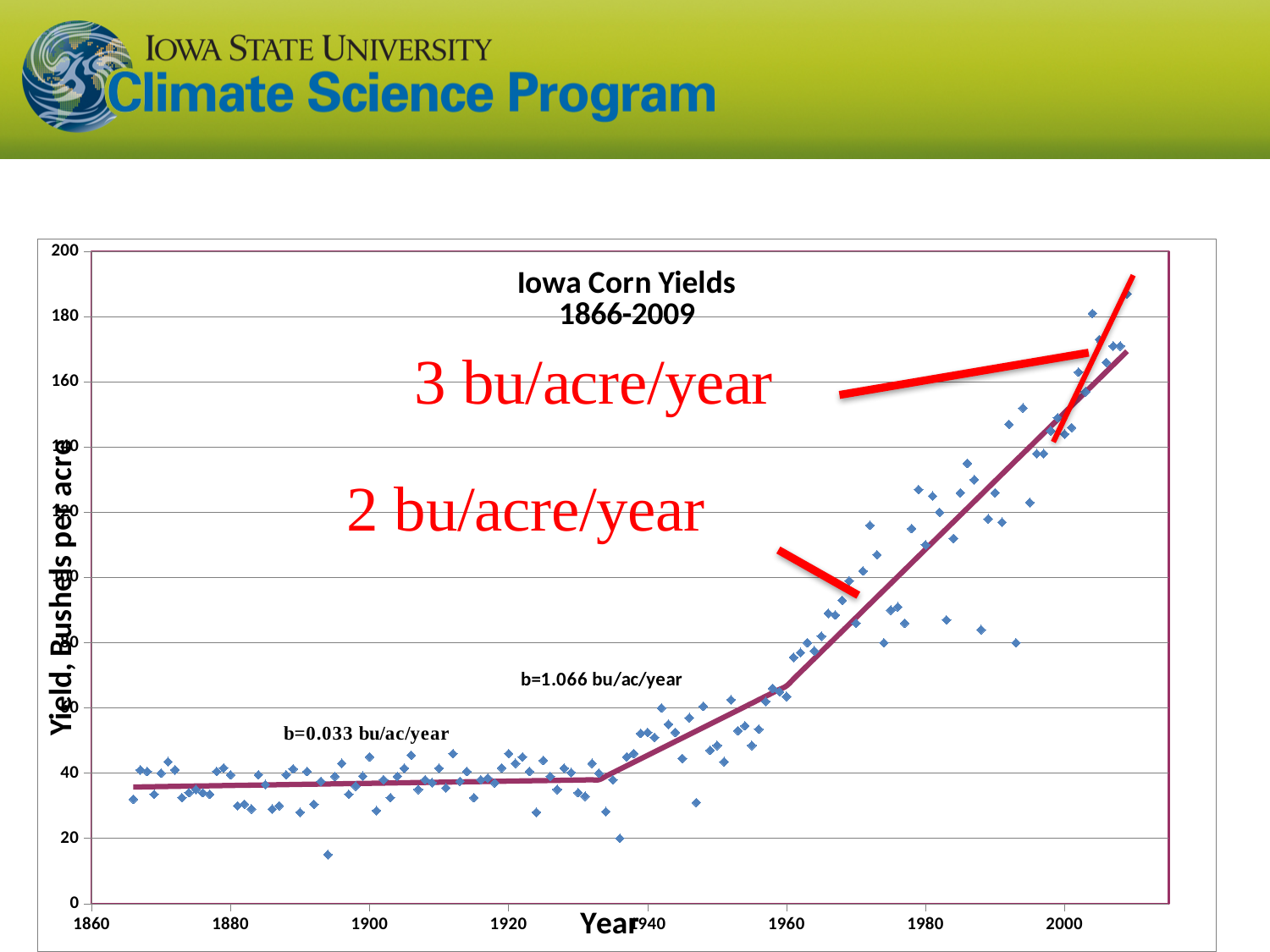
Is the yield value for 1900 greater or less than 60 bushels per acre? less What is the label of the y axis? Yield, Bushels per acre What slope is printed for the trend line segment starting around 1930? b=1.066 bu/ac/year What slope is printed for the trend line segment covering the earliest years (1866 to about 1930)? b=0.033 bu/ac/year What is the highest value shown on the y axis? 200 Is the yield value for 1960 greater or less than 40 bushels per acre? greater What is the title of the chart? Iowa Corn Yields 1866-2009 Is the yield value for 1880 greater or less than 80 bushels per acre? less Do corn yields generally rise or fall from 1940 to 2009? rise What kind of chart is shown on the slide? scatter plot Which year has the higher corn yield, 1890 or 2005? 2005